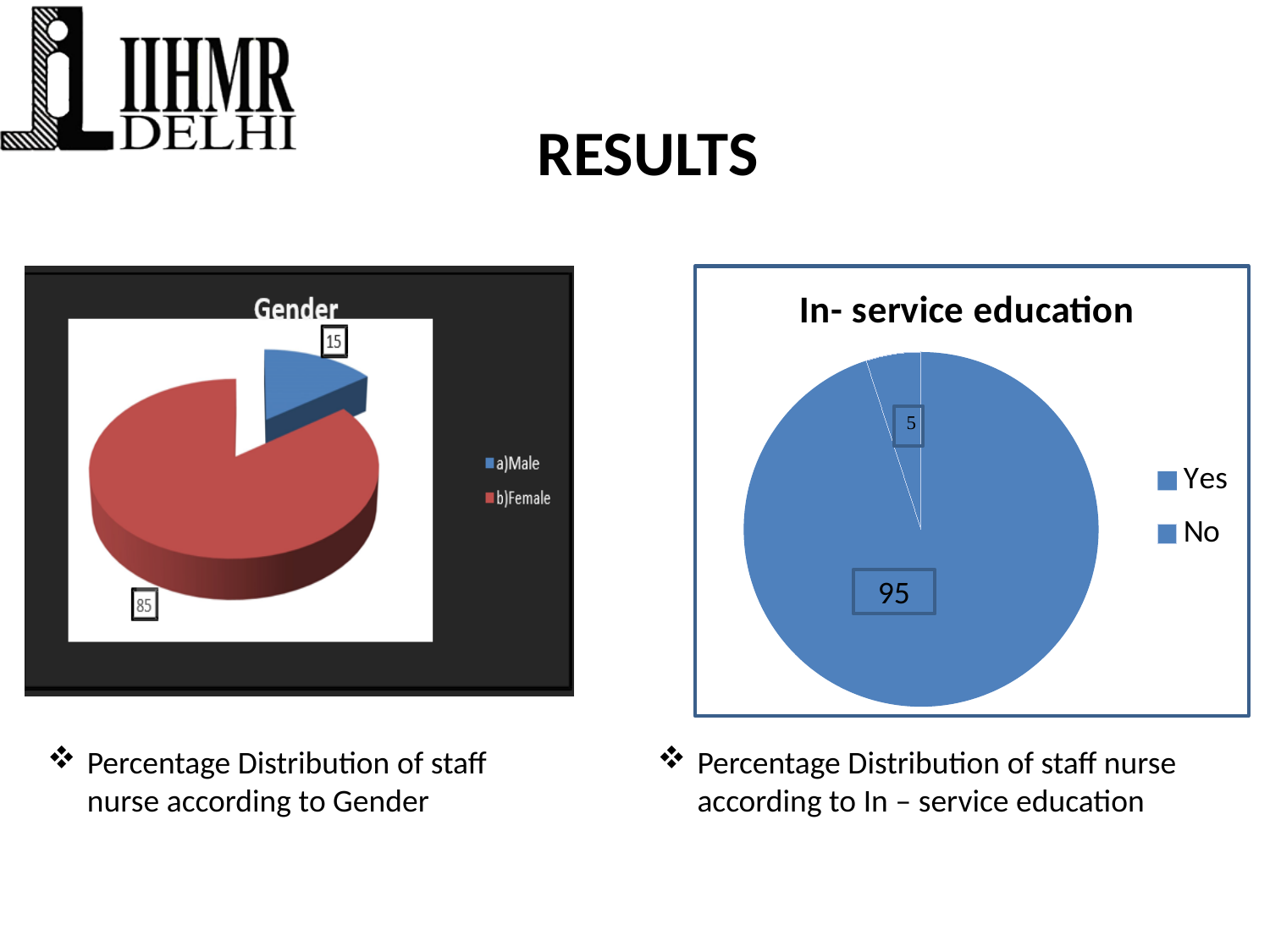
In the Gender chart, what is the value for b)Female? 85 In the Gender chart, what is the value for a)Male? 15 How many categories does the Gender chart's legend list? 2 In the Gender chart, which category has the largest slice? b)Female In the In- service education chart, what value is printed on the small slice? 5 How many entries does the legend of the In- service education chart list? 2 What kind of chart is the Gender chart? pie chart In the Gender chart, which is larger, the value for a)Male or the value for b)Female? b)Female In the Gender chart, which category has the smallest slice? a)Male What kind of chart is the In- service education chart? pie chart In the In- service education chart, what value is printed on the large slice? 95 In the Gender chart, what is the difference between the values for b)Female and a)Male? 70